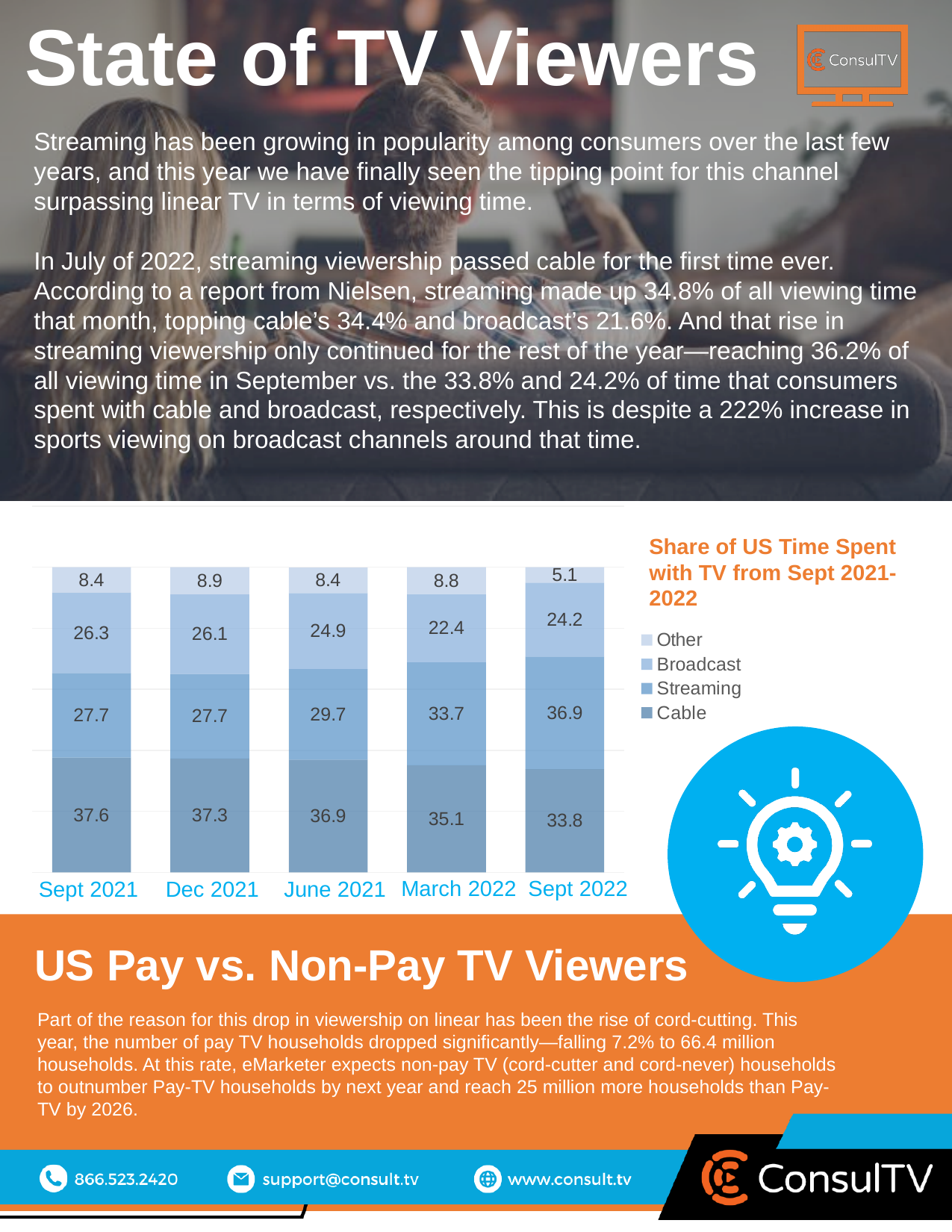
What is the Cable value for Sept 2021? 37.6 What type of chart is shown on the slide? Stacked bar chart Which is larger in Sept 2022, the Streaming value or the Cable value? Streaming What is the Other value for Dec 2021? 8.9 How many series does the legend of the 'Share of US Time Spent with TV' chart list? 4 Does the Streaming value rise or fall from Sept 2021 to Sept 2022? Rise In which period is the Cable value lowest? Sept 2022 What is the difference between the Cable value in Sept 2021 and the Cable value in Sept 2022? 3.8 What is the Streaming value for Sept 2022? 36.9 In which period is the Streaming value highest? Sept 2022 How many time periods are shown along the x axis of the chart? 5 What is the Broadcast value for March 2022? 22.4